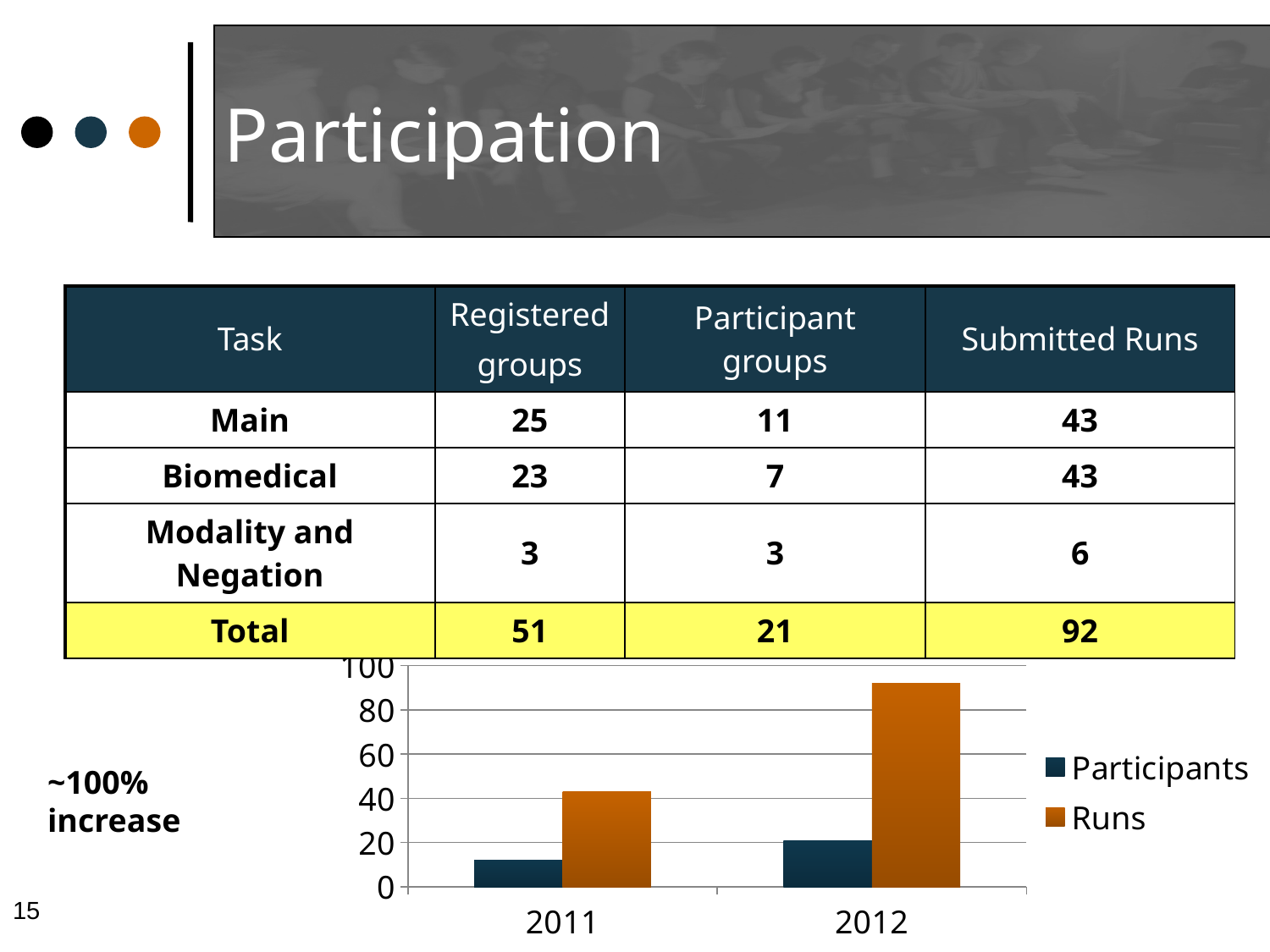
Is the Runs bar larger in 2011 or 2012? 2012 Which series and year has the tallest bar in the chart? Runs in 2012 Is the value for Runs in 2012 greater or less than 80? greater What kind of chart is shown on the slide? bar chart Is the value for Participants in 2011 greater or less than 20? less Which series and year has the shortest bar in the chart? Participants in 2011 How many series does the chart legend list? 2 What colour are the Runs bars in the chart? orange Do the Runs values rise or fall from 2011 to 2012? rise Is the value for Runs in 2011 greater or less than 60? less Is the Participants bar larger in 2011 or 2012? 2012 How many years are shown on the x axis of the chart? 2